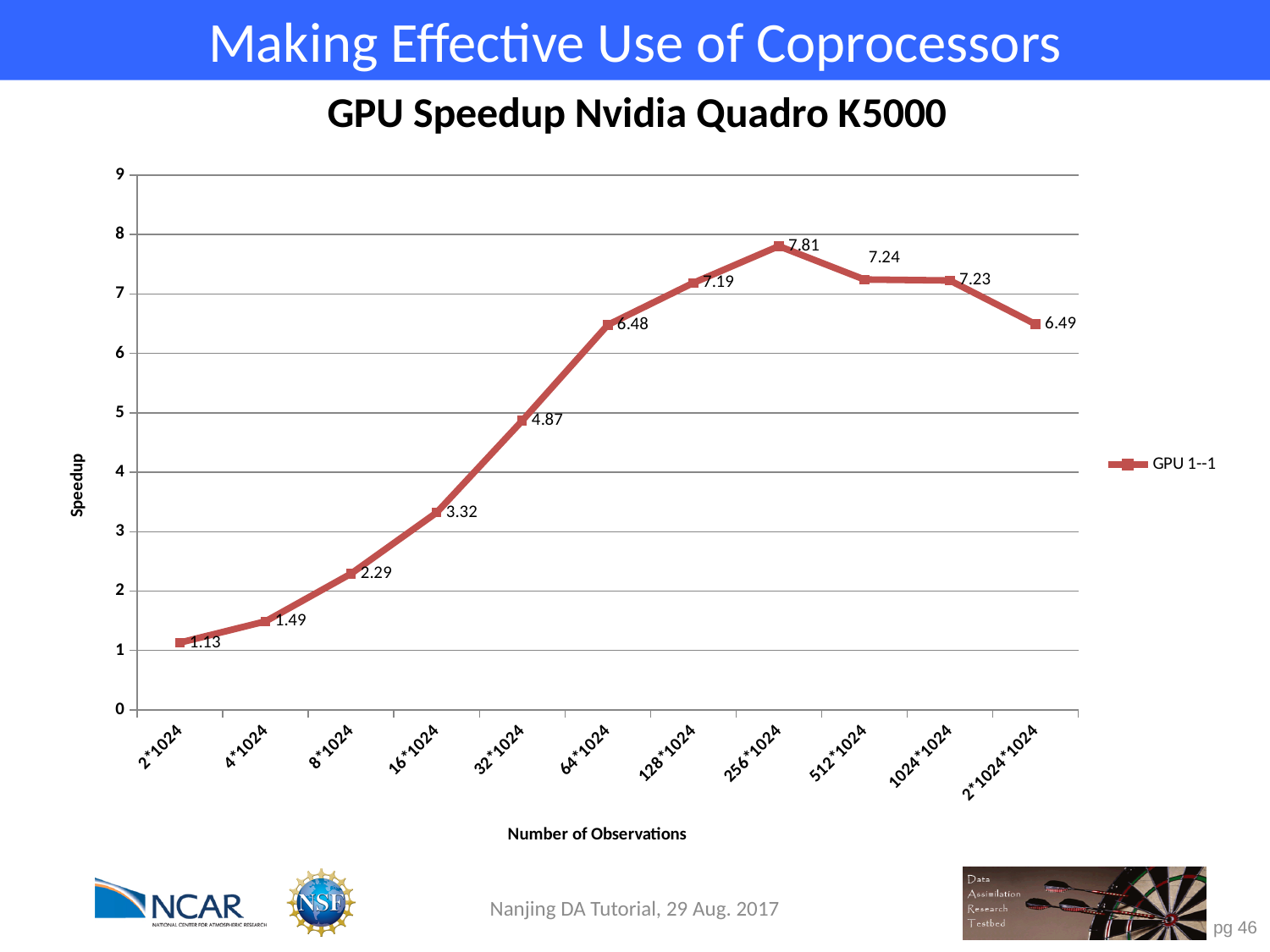
What is the difference between the speedup at 256*1024 and at 2*1024*1024 observations? 1.32 At which number of observations is the speedup lowest? 2*1024 Is the speedup for 16*1024 observations greater or less than 3? greater At which number of observations is the speedup highest? 256*1024 Which has a larger speedup: 32*1024 or 128*1024 observations? 128*1024 What is the speedup value for 2*1024 observations? 1.13 How many series does the legend list? 1 What kind of chart is shown on the slide? line chart What is the speedup value for 512*1024 observations? 7.24 What is the title of the chart? GPU Speedup Nvidia Quadro K5000 What is the speedup value for 64*1024 observations? 6.48 How many data points are plotted on the chart? 11